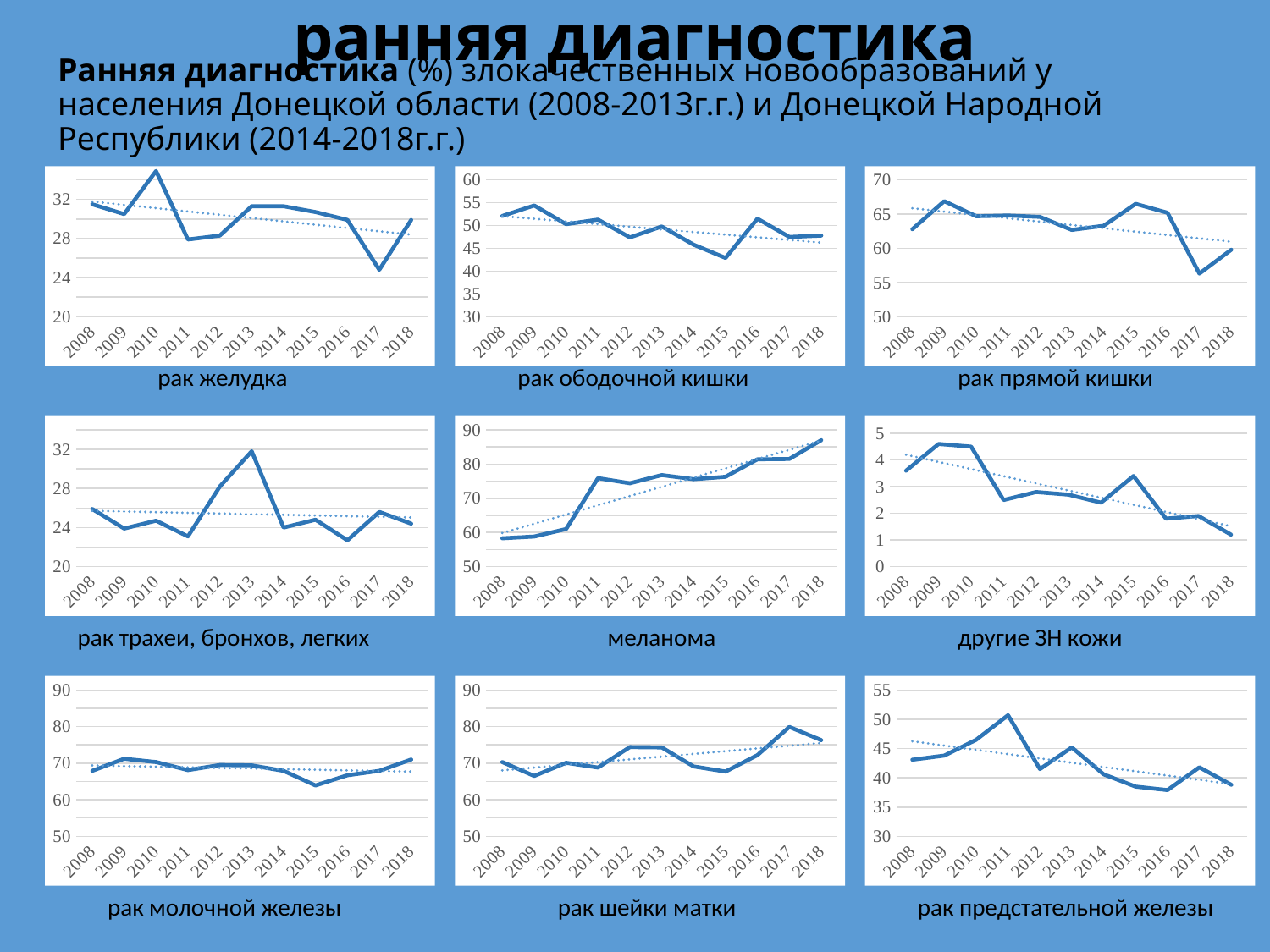
In the 'меланома' chart, is the value for 2018 greater or less than 80? greater In the 'рак прямой кишки' chart, is the value for 2017 greater or less than 60? less In the 'рак желудка' chart, which year has the lowest value? 2017 How many charts are shown on the slide? 9 In the 'рак желудка' chart, which year has the highest value? 2010 In the 'рак предстательной железы' chart, which year has the highest value? 2011 In the 'меланома' chart, do the values generally rise or fall from 2008 to 2018? rise In the 'рак ободочной кишки' chart, which year has the lowest value? 2015 In the 'меланома' chart, how many years are plotted on the x axis? 11 In the 'рак желудка' chart, is the value for 2010 greater or less than 32? greater What type of chart is used for 'рак желудка'? line chart